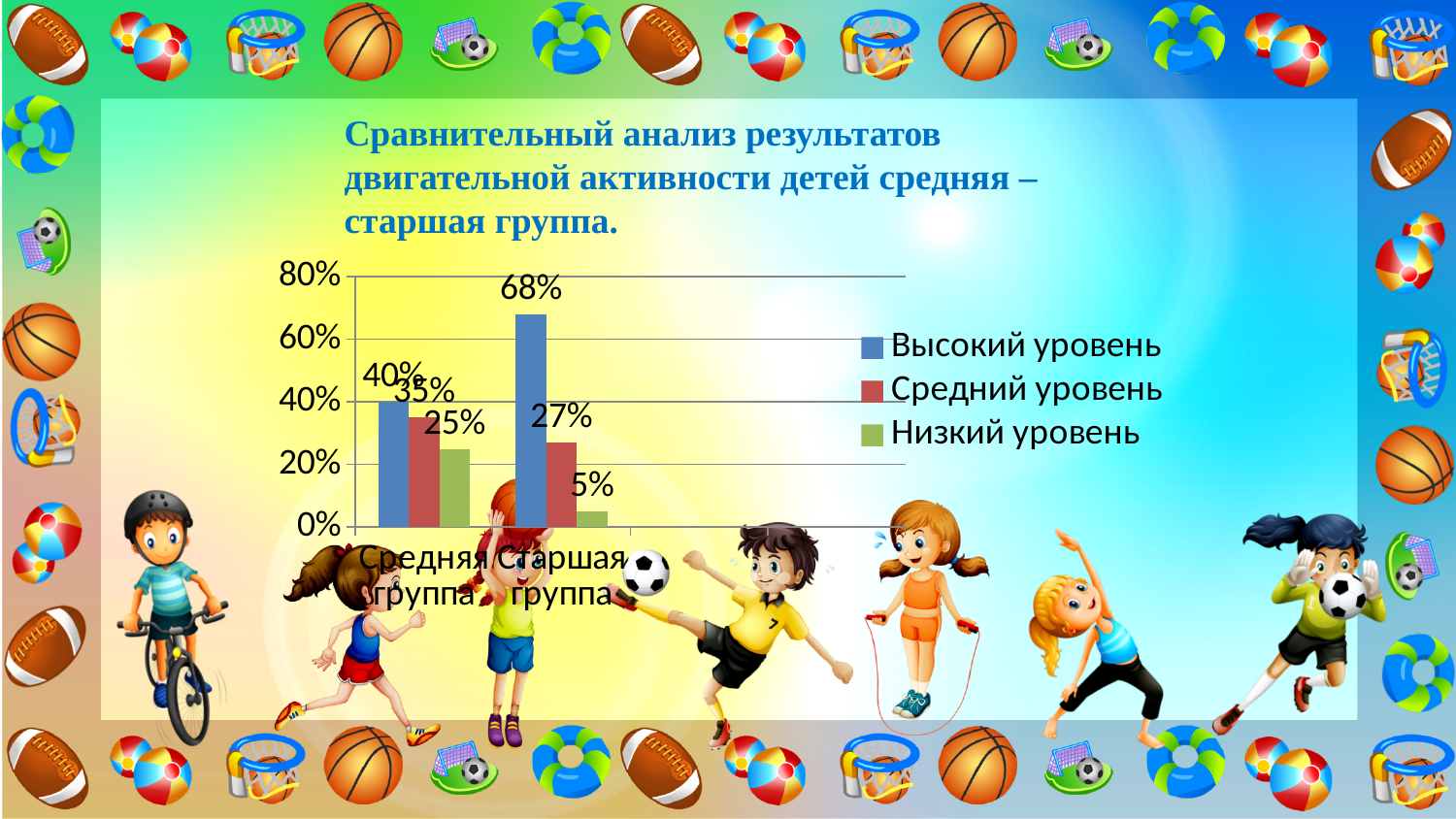
How many categories are shown on the x axis? 2 What kind of chart is shown on the slide? bar chart What is the value of Средний уровень for Старшая группа? 27% Which series has the lowest value for Старшая группа? Низкий уровень How many series does the legend list? 3 What is the value of Низкий уровень for Средняя группа? 25% What is the value of Высокий уровень for Старшая группа? 68% What is the value of Низкий уровень for Старшая группа? 5% Which category has the highest value for Высокий уровень? Старшая группа What is the difference between Высокий уровень for Старшая группа and Средняя группа? 28% Which is larger: Средний уровень for Средняя группа or Средний уровень for Старшая группа? Средняя группа Which series is shown in green in the legend? Низкий уровень